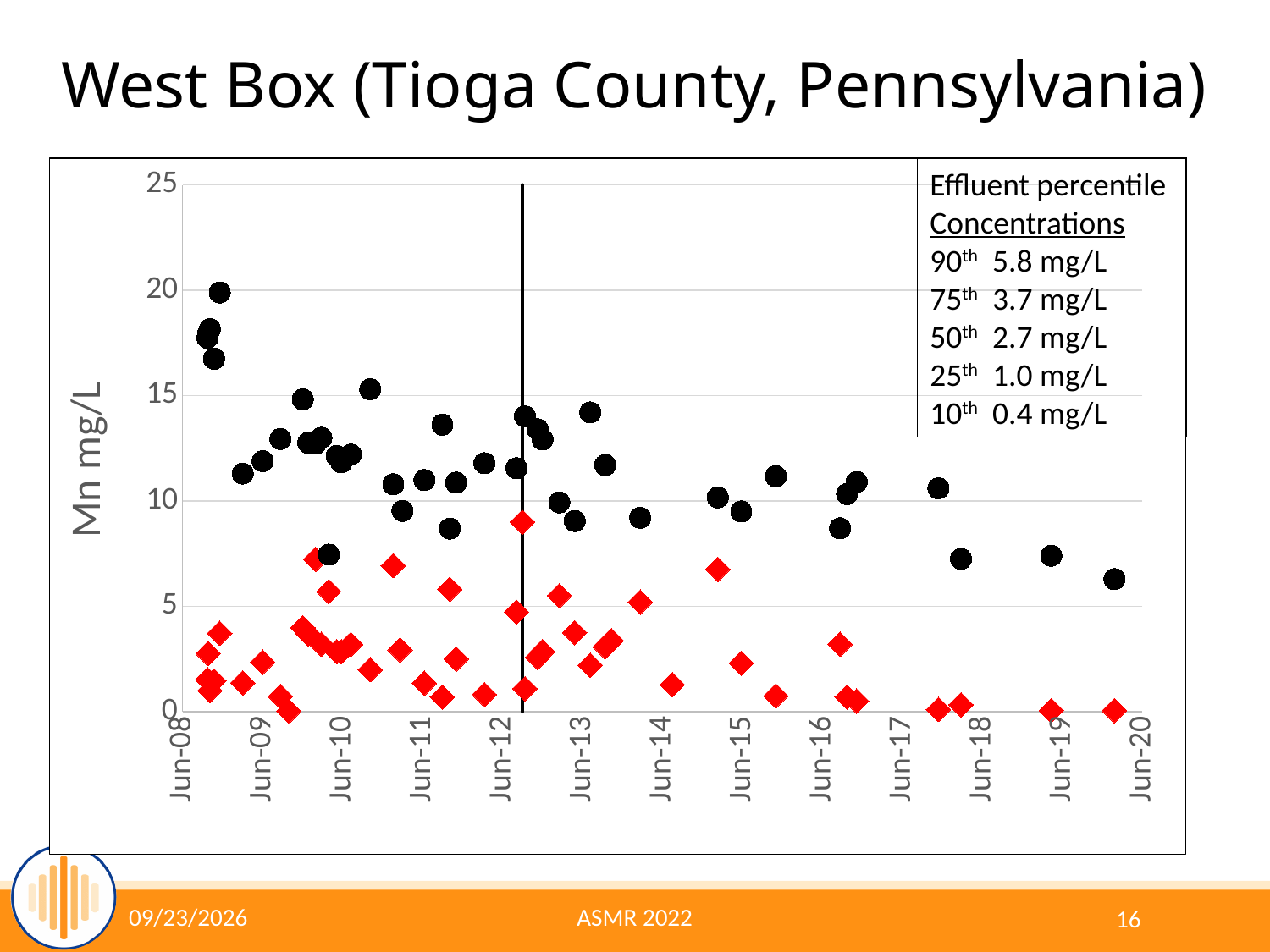
Which is larger: the black circle values near Jun-08 or the black circle value near Jun-20? Jun-08 Is the highest red diamond value on the chart greater or less than 10? less Is the highest black circle value on the chart greater or less than 15? greater What is the maximum value shown on the vertical axis of the chart? 25 According to the effluent percentile box, what is the 90th percentile concentration? 5.8 mg/L What is the label on the vertical axis of the chart? Mn mg/L Is the last red diamond value near Jun-20 greater or less than 5? less What kind of chart is shown on the slide? Scatter chart How many distinct marker series (black circles and red diamonds) are plotted on the chart? 2 Do the black circle values generally rise or fall from Jun-08 to Jun-20? Fall According to the effluent percentile box, what is the 50th percentile concentration? 2.7 mg/L